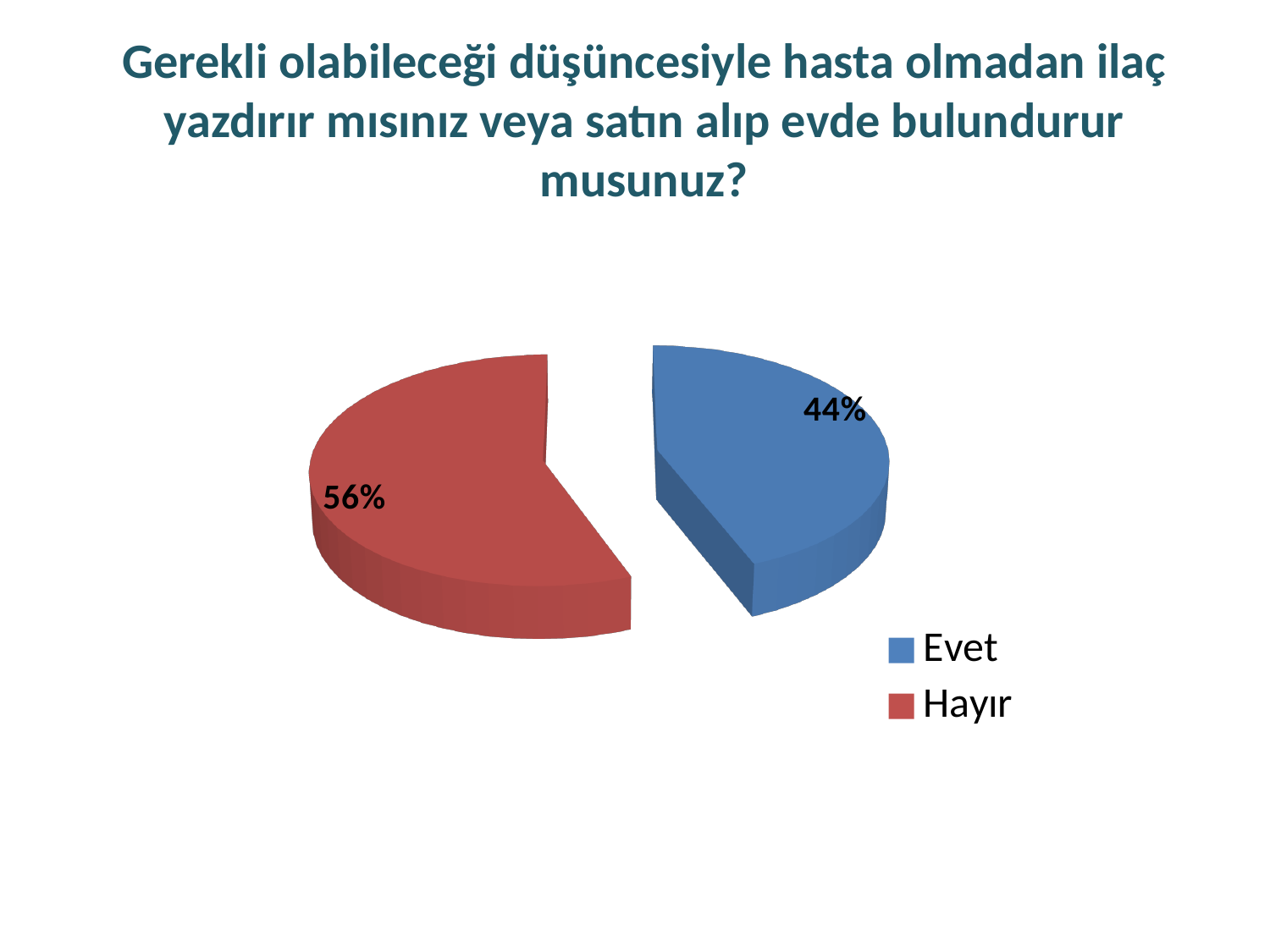
What colour is the Evet slice? Blue How many slices does the pie chart have? 2 Which category has the largest slice of the pie? Hayır What is the difference in percentage points between Hayır and Evet? 12 Which is larger, the share for Evet or the share for Hayır? Hayır What kind of chart is shown on the slide? Pie chart Is the share for Evet greater or less than 50%? less What share of the pie does Hayır represent? 56% What colour is the Hayır slice? Red What share of the pie does Evet represent? 44% Which category has the smallest slice of the pie? Evet How many entries does the legend list? 2